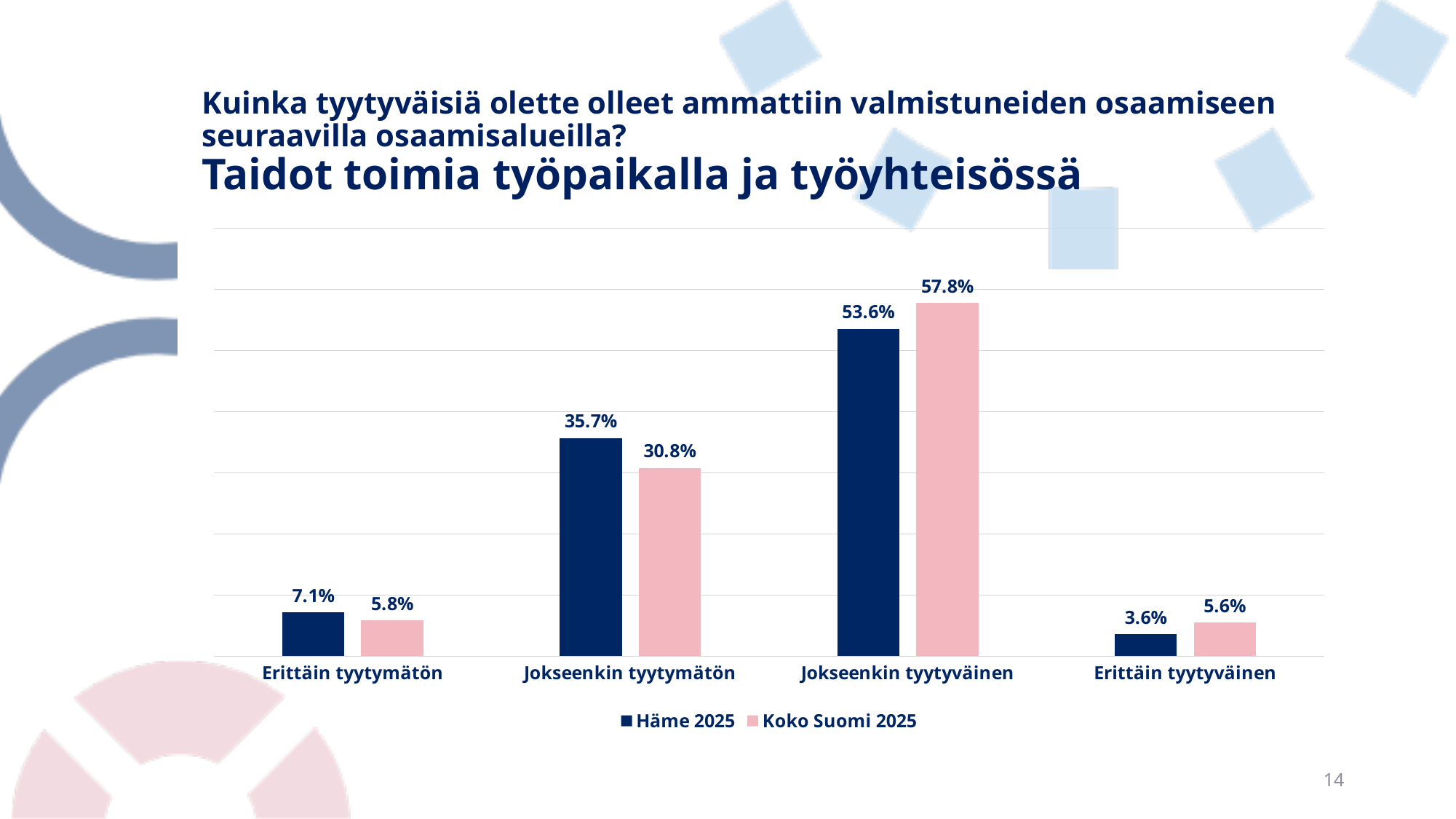
What is the value for Koko Suomi 2025 in the Jokseenkin tyytymätön category? 30.8% What is the value for Häme 2025 in the Erittäin tyytyväinen category? 3.6% In the Erittäin tyytyväinen category, which series has the larger value, Häme 2025 or Koko Suomi 2025? Koko Suomi 2025 How many categories are shown on the x axis? 4 What is the value for Häme 2025 in the Jokseenkin tyytyväinen category? 53.6% Which category has the lowest value for Häme 2025? Erittäin tyytyväinen What is the difference between Koko Suomi 2025 and Häme 2025 in the Jokseenkin tyytyväinen category? 4.2% Which category has the highest value for Koko Suomi 2025? Jokseenkin tyytyväinen What is the value for Koko Suomi 2025 in the Erittäin tyytymätön category? 5.8% What kind of chart is shown on the slide? Bar chart What is the difference between Häme 2025 and Koko Suomi 2025 in the Jokseenkin tyytymätön category? 4.9% How many series does the legend list? 2